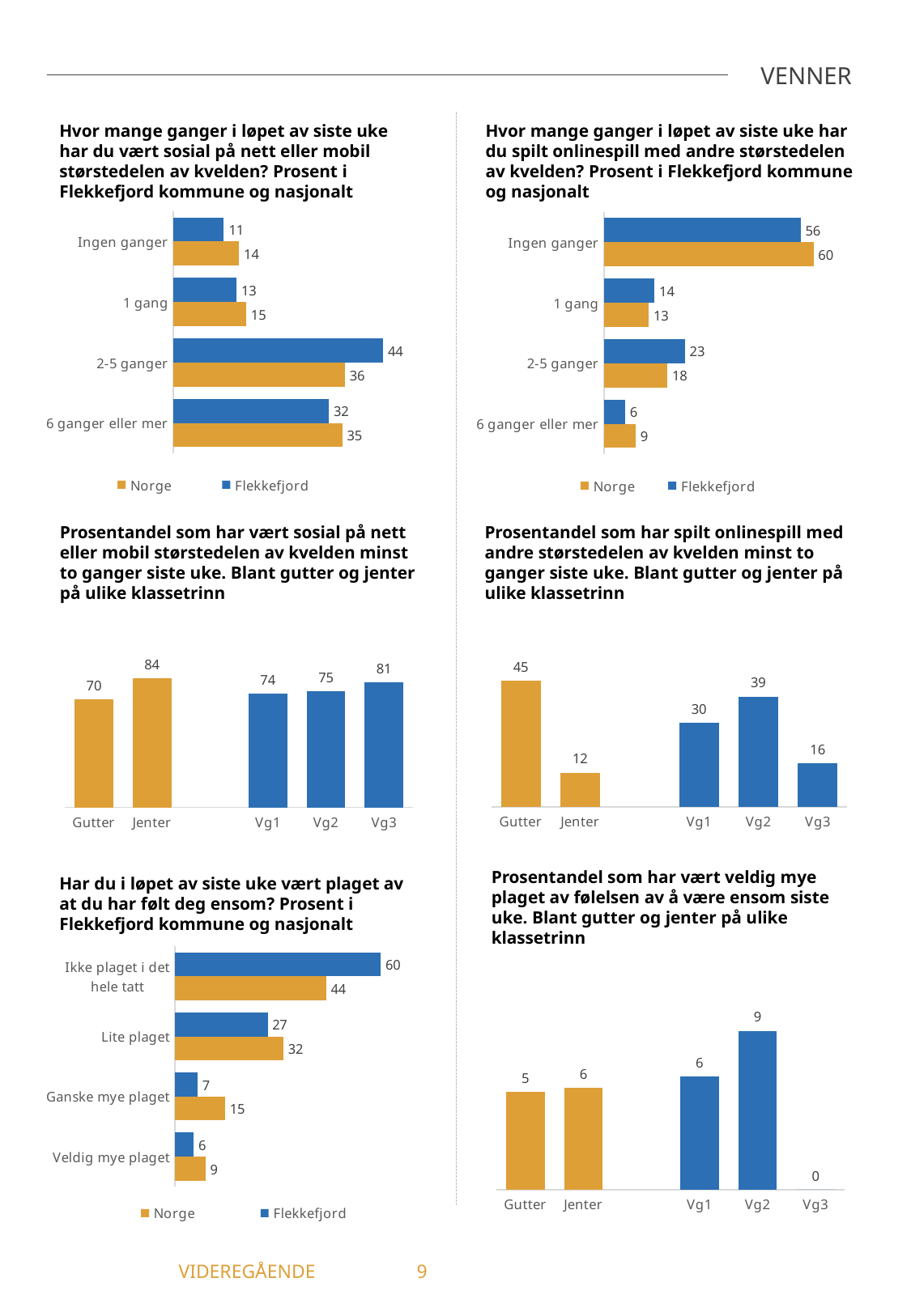
In the top-left chart (sosial på nett eller mobil), what is the difference between the Norge and Flekkefjord values for 'Ingen ganger'? 3 In the middle-left chart (sosial på nett minst to ganger, gutter og jenter), what is the value for Vg2? 75 In the bottom-left chart (plaget av å ha følt deg ensom), what is the value for Norge for 'Ganske mye plaget'? 15 In the middle-left chart (sosial på nett minst to ganger, gutter og jenter), which category has the highest value? Jenter What kind of chart is the bottom-right chart (veldig mye plaget av følelsen av å være ensom)? Bar chart In the top-left chart (sosial på nett eller mobil), what is the value for Flekkefjord for '2-5 ganger'? 44 In the middle-right chart (spilt onlinespill minst to ganger, gutter og jenter), which category has the lowest value? Jenter In the top-right chart (spilt onlinespill), which category has the highest value for Norge? Ingen ganger In the bottom-left chart (plaget av å ha følt deg ensom), which is larger for 'Ikke plaget i det hele tatt': Norge or Flekkefjord? Flekkefjord In the top-right chart (spilt onlinespill), what is the value for Flekkefjord for '6 ganger eller mer'? 6 In the middle-right chart (spilt onlinespill minst to ganger, gutter og jenter), how many categories are shown? 5 In the top-right chart (spilt onlinespill), how many series does the legend list? 2